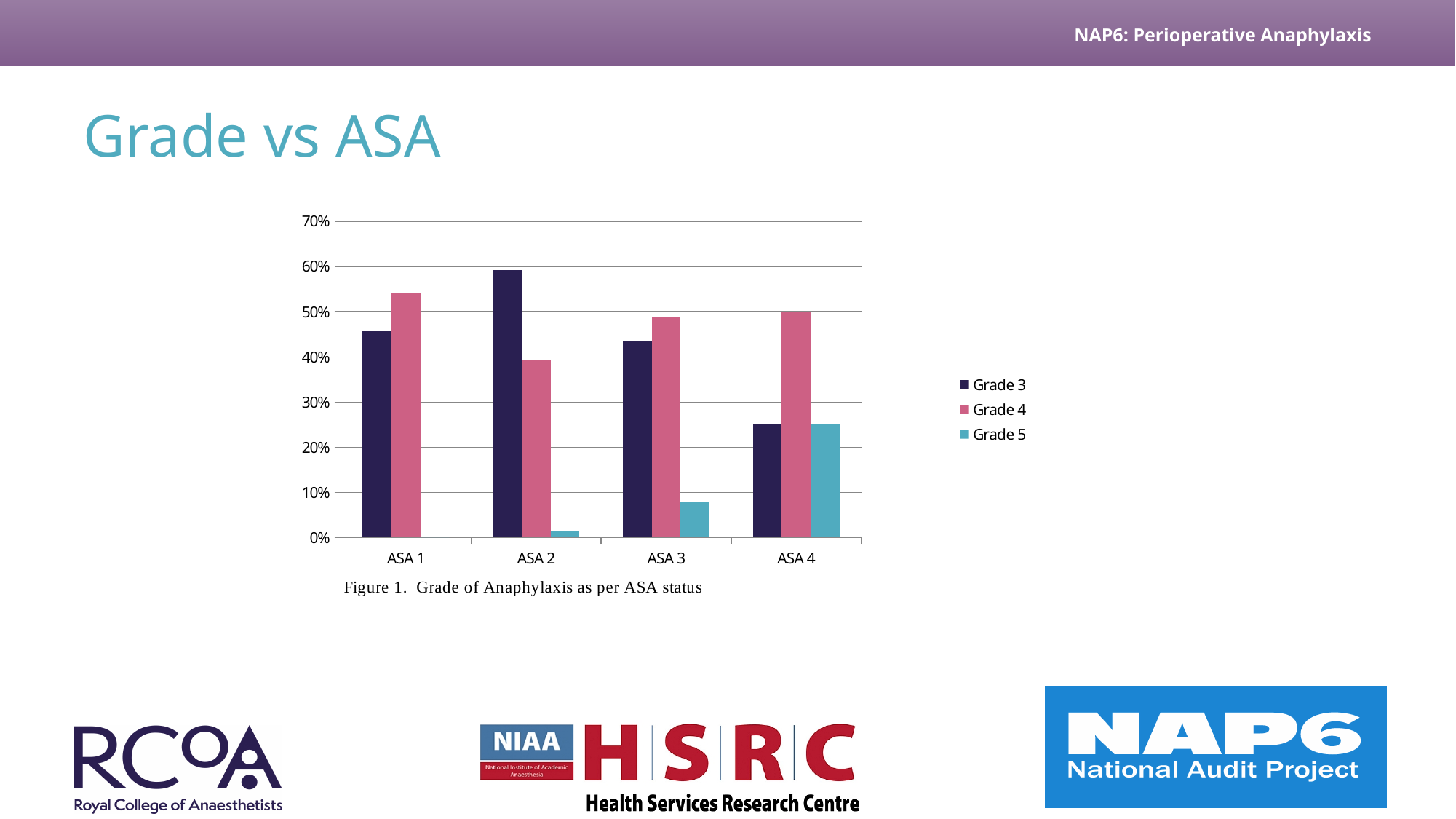
Which is larger at ASA 2, the Grade 3 value or the Grade 4 value? Grade 3 For which ASA category is the Grade 3 value highest? ASA 2 For which ASA category is the Grade 3 value lowest? ASA 4 Which is larger at ASA 1, the Grade 3 value or the Grade 4 value? Grade 4 Is the Grade 3 value for ASA 2 greater or less than 50%? greater What is the figure caption below the chart? Figure 1. Grade of Anaphylaxis as per ASA status How many series does the legend list? 3 What kind of chart is shown on the slide? bar chart How many ASA categories are shown on the x axis? 4 Is the Grade 5 value for ASA 3 greater or less than 10%? less Does the Grade 5 value rise or fall as you move from ASA 1 to ASA 4? rise For which ASA category is the Grade 5 value highest? ASA 4